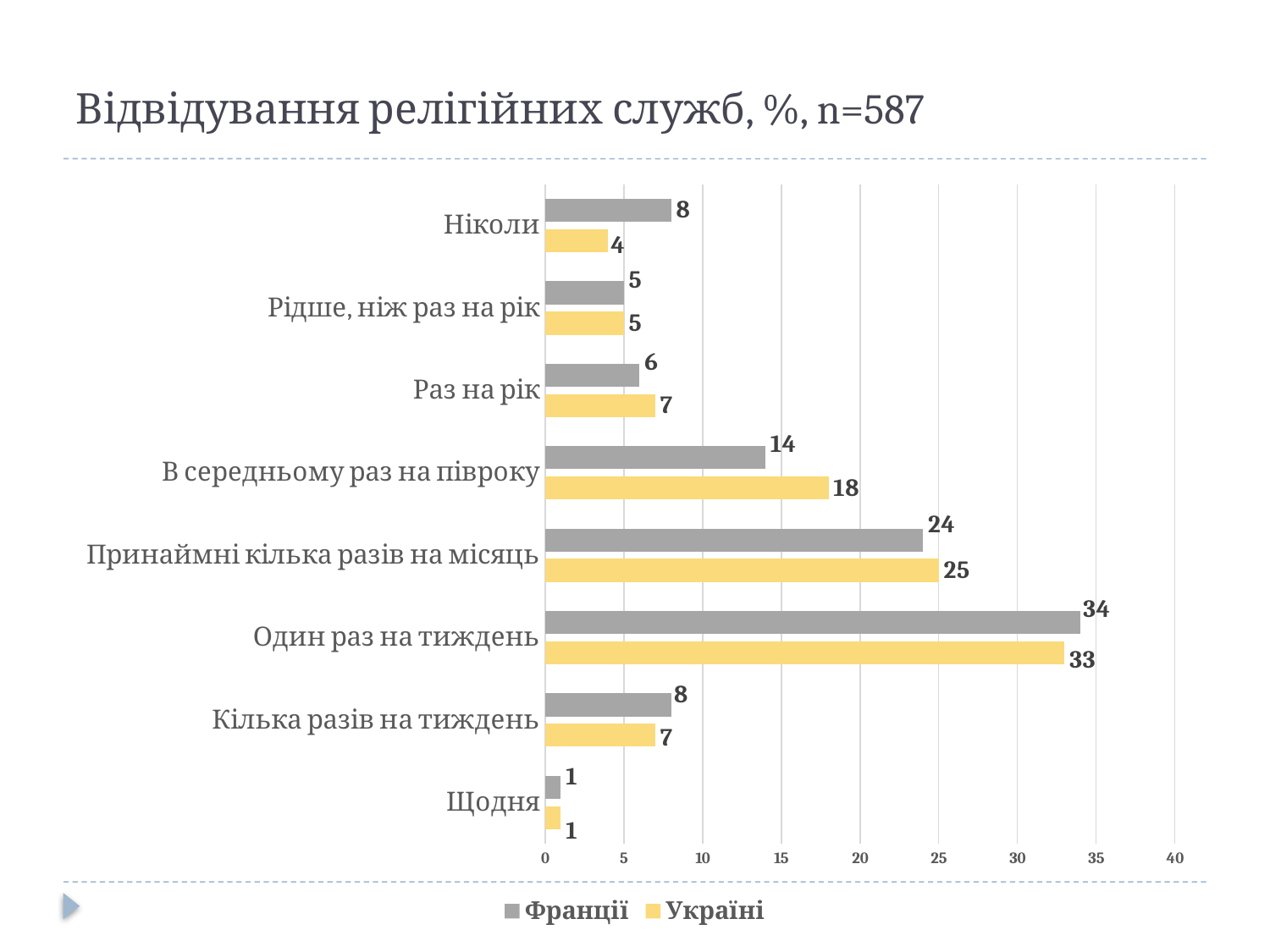
What is the difference between the Україні and Франції values for 'В середньому раз на півроку'? 4 How many categories are shown on the chart? 8 Which is larger for 'Принаймні кілька разів на місяць': Франції or Україні? Україні What is the difference between the Франції and Україні values for 'Ніколи'? 4 What is the value for Франції in the category 'Один раз на тиждень'? 34 How many series does the legend list? 2 What is the value for Україні in the category 'Ніколи'? 4 Which category has the highest value for Україні? Один раз на тиждень Which category has the lowest value for Франції? Щодня What is the title of the chart? Відвідування релігійних служб, %, n=587 What is the value for Україні in the category 'В середньому раз на півроку'? 18 What kind of chart is shown on the slide? Bar chart